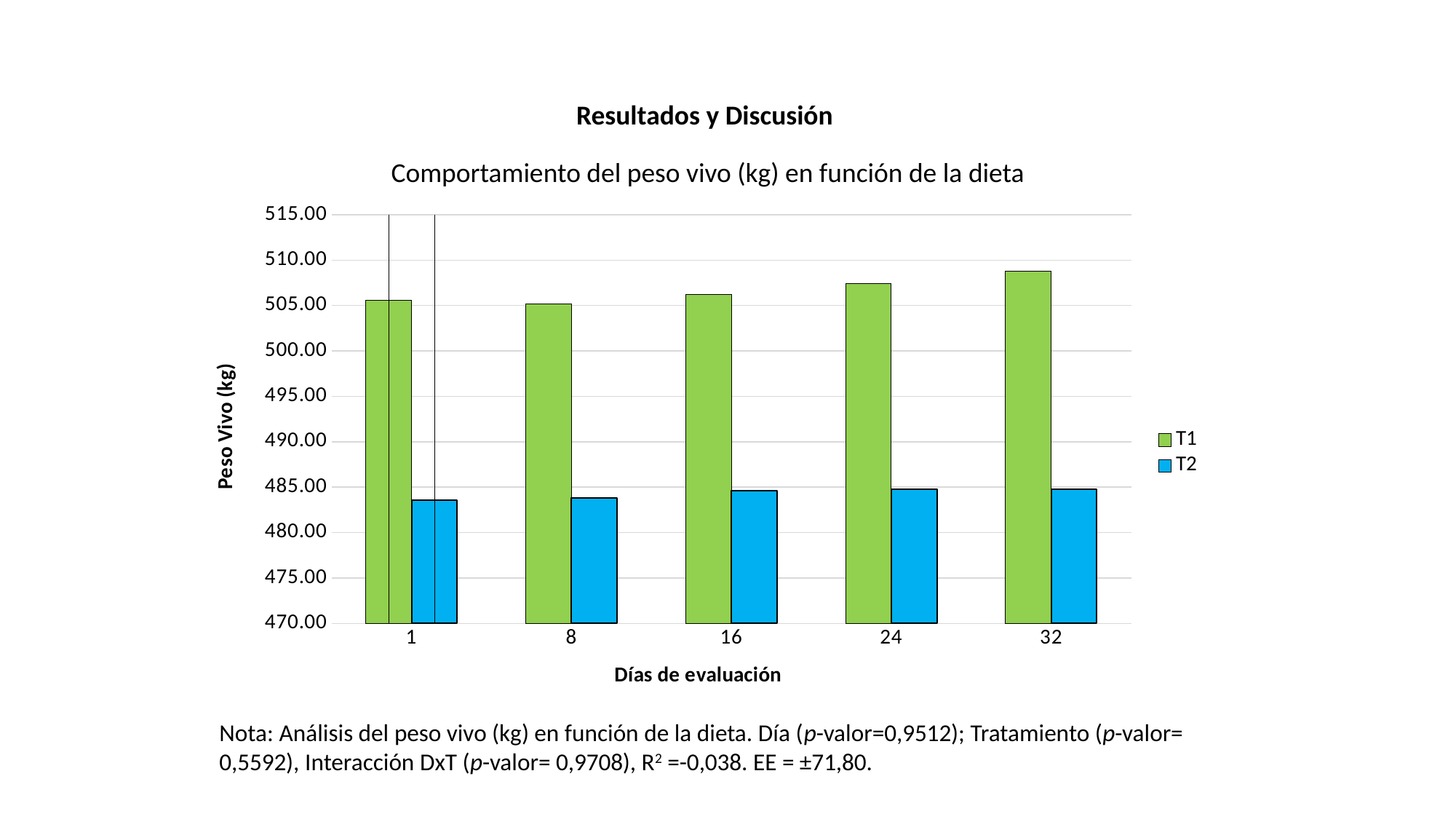
What is the label of the y axis? Peso Vivo (kg) How many series does the legend list? 2 Which series has the larger value on day 8, T1 or T2? T1 How many evaluation days (categories) are shown on the x axis? 5 Is the value for T1 on day 1 greater or less than 500.00? greater Is the value for T2 on day 1 greater or less than 485.00? less What is the title of the chart? Comportamiento del peso vivo (kg) en función de la dieta Is the value for T2 on day 16 greater or less than 490.00? less What kind of chart is shown on the slide? Bar chart Do the T1 values rise or fall from day 8 to day 32? rise On which evaluation day is the T1 value highest? 32